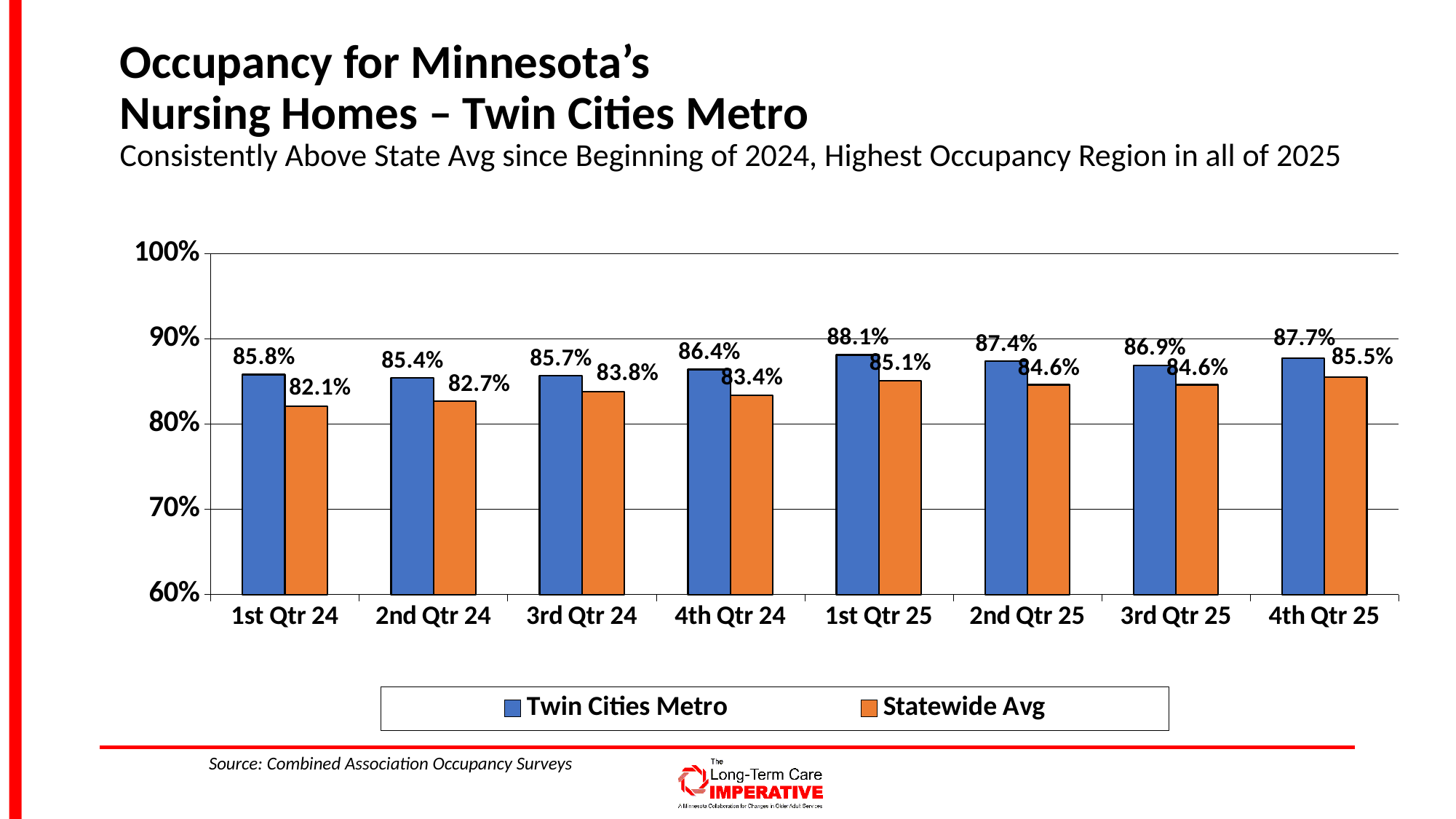
How many quarters are shown on the x axis? 8 What kind of chart is shown on the slide? Bar chart Which colour represents the Statewide Avg series? Orange What is the Twin Cities Metro occupancy for 1st Qtr 25? 88.1% What is the Statewide Avg occupancy for 3rd Qtr 24? 83.8% In which quarter is the Statewide Avg occupancy lowest? 1st Qtr 24 What is the Statewide Avg occupancy for 4th Qtr 25? 85.5% Which is larger in 4th Qtr 24: the Twin Cities Metro value or the Statewide Avg value? Twin Cities Metro In which quarter is the Twin Cities Metro occupancy highest? 1st Qtr 25 Is the Statewide Avg value for 2nd Qtr 24 greater or less than 90%? less What is the difference between the Twin Cities Metro and Statewide Avg occupancy in 1st Qtr 24? 3.7% How many series does the legend list? 2